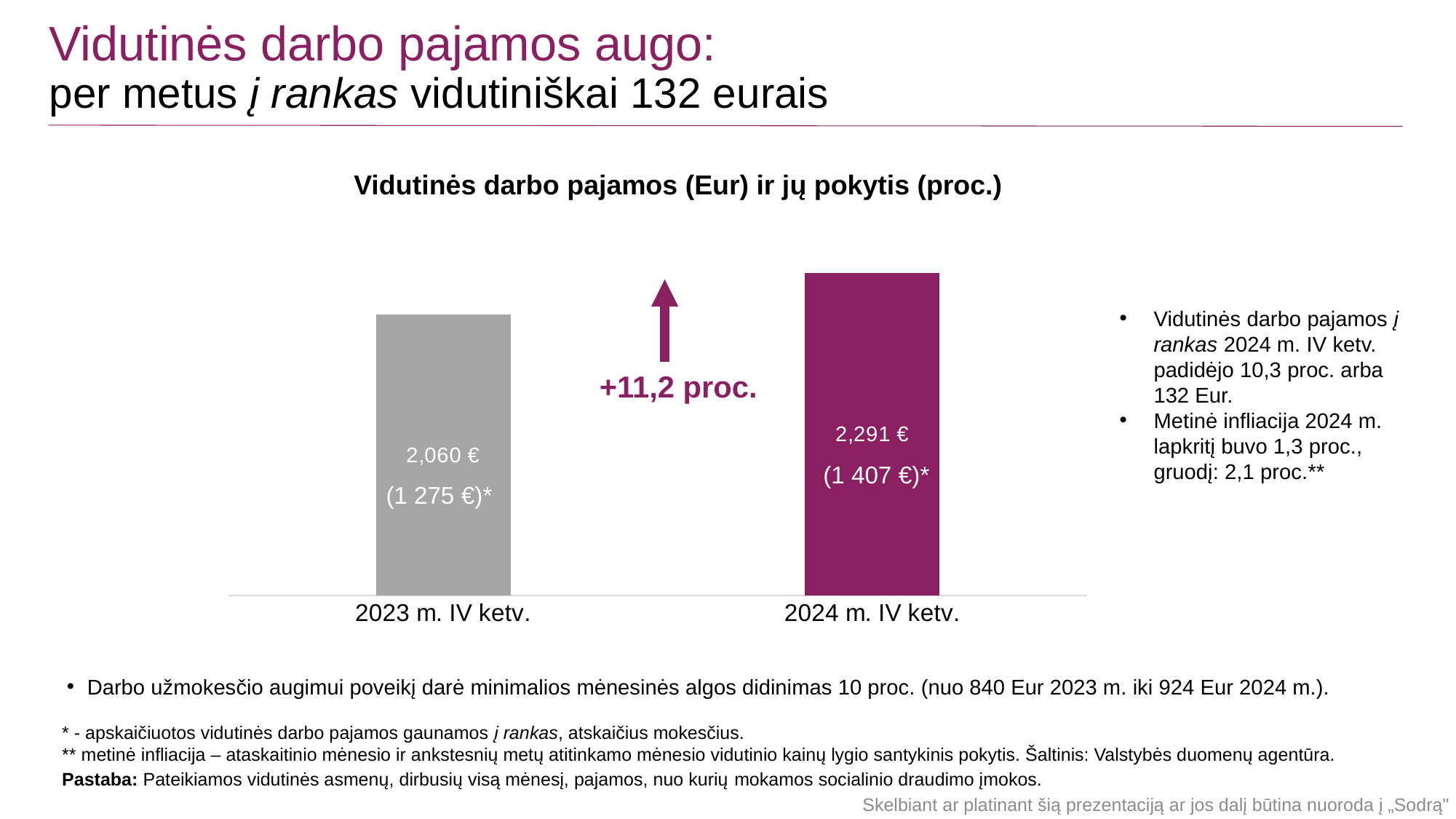
What is the difference between the net (į rankas) values for 2024 m. IV ketv. and 2023 m. IV ketv.? 132 € What is the average labour income value shown for 2024 m. IV ketv.? 2,291 € Which quarter has the higher average labour income? 2024 m. IV ketv. Which quarter has the lower average labour income? 2023 m. IV ketv. What net (į rankas) value is shown in parentheses for the 2023 m. IV ketv. bar? 1 275 € What is the difference in average labour income between 2024 m. IV ketv. and 2023 m. IV ketv.? 231 € What type of chart is shown on the slide? Bar chart What is the title of the chart? Vidutinės darbo pajamos (Eur) ir jų pokytis (proc.) What is the average labour income value shown for 2023 m. IV ketv.? 2,060 € How many bars are shown in the chart? 2 What percentage change is shown between the two bars? +11,2 proc. What net (į rankas) value is shown in parentheses for the 2024 m. IV ketv. bar? 1 407 €